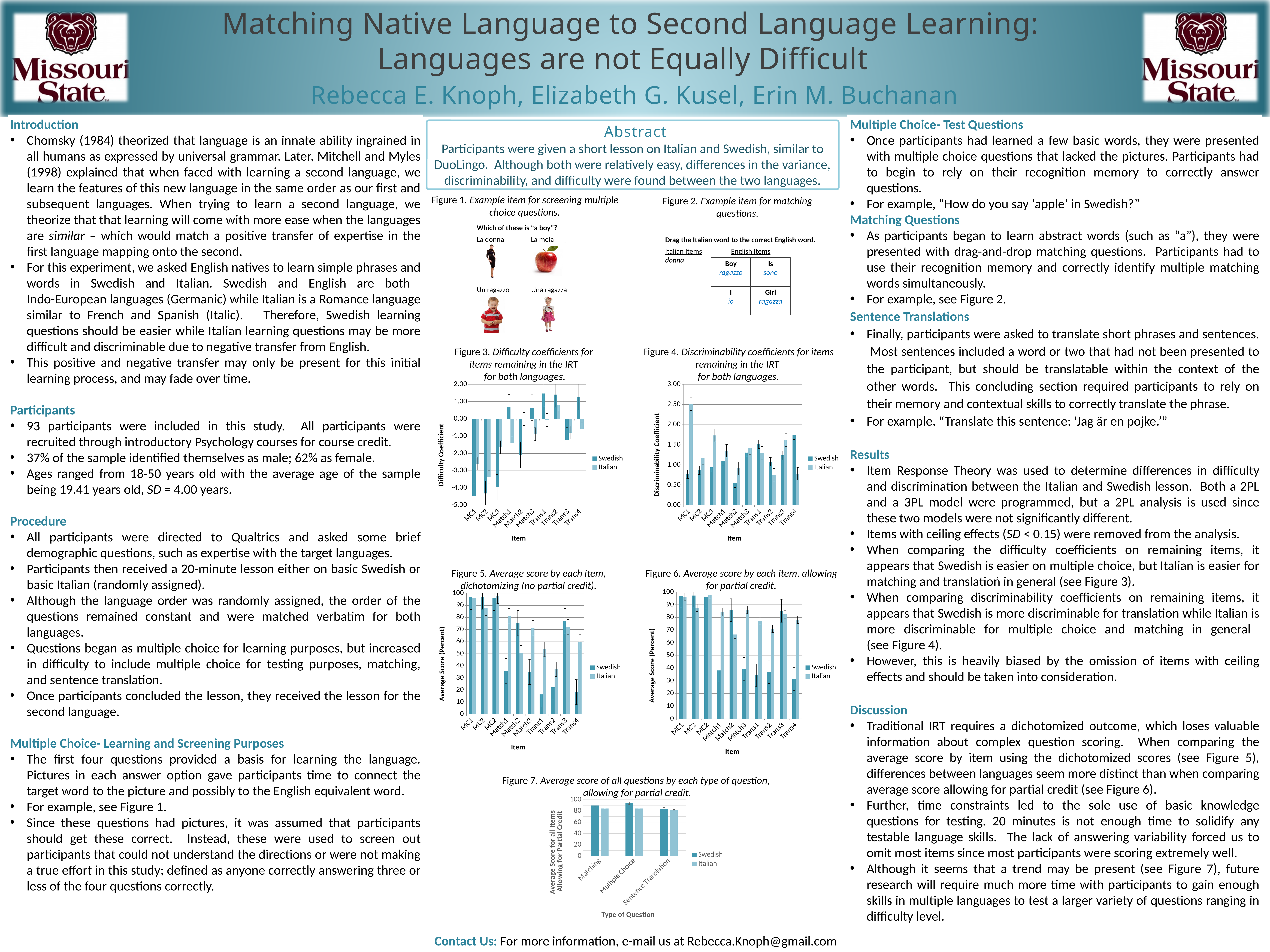
In Figure 4 (Discriminability coefficients), which item has the highest Italian discriminability coefficient? MC1 In Figure 4 (Discriminability coefficients), is the Italian value for MC1 greater or less than 2.00? greater In Figure 3 (Difficulty coefficients), how many series does the legend list? 2 In Figure 3 (Difficulty coefficients), how many items are shown on the x axis? 10 In Figure 7 (Average score by type of question), how many types of question are shown on the x axis? 3 In Figure 5 (Average score, no partial credit), which is larger for Match1, the Swedish or the Italian average score? Italian What kind of chart is Figure 7 (Average score by type of question)? bar chart In Figure 3 (Difficulty coefficients), which is larger for Match1, the Swedish or the Italian difficulty coefficient? Swedish In Figure 4 (Discriminability coefficients), which is larger for Trans4, the Swedish or the Italian value? Swedish In Figure 6 (Average score, allowing partial credit), is the Italian value for Match1 greater or less than 70? greater In Figure 3 (Difficulty coefficients), is the Swedish value for MC1 greater or less than -3.00? less